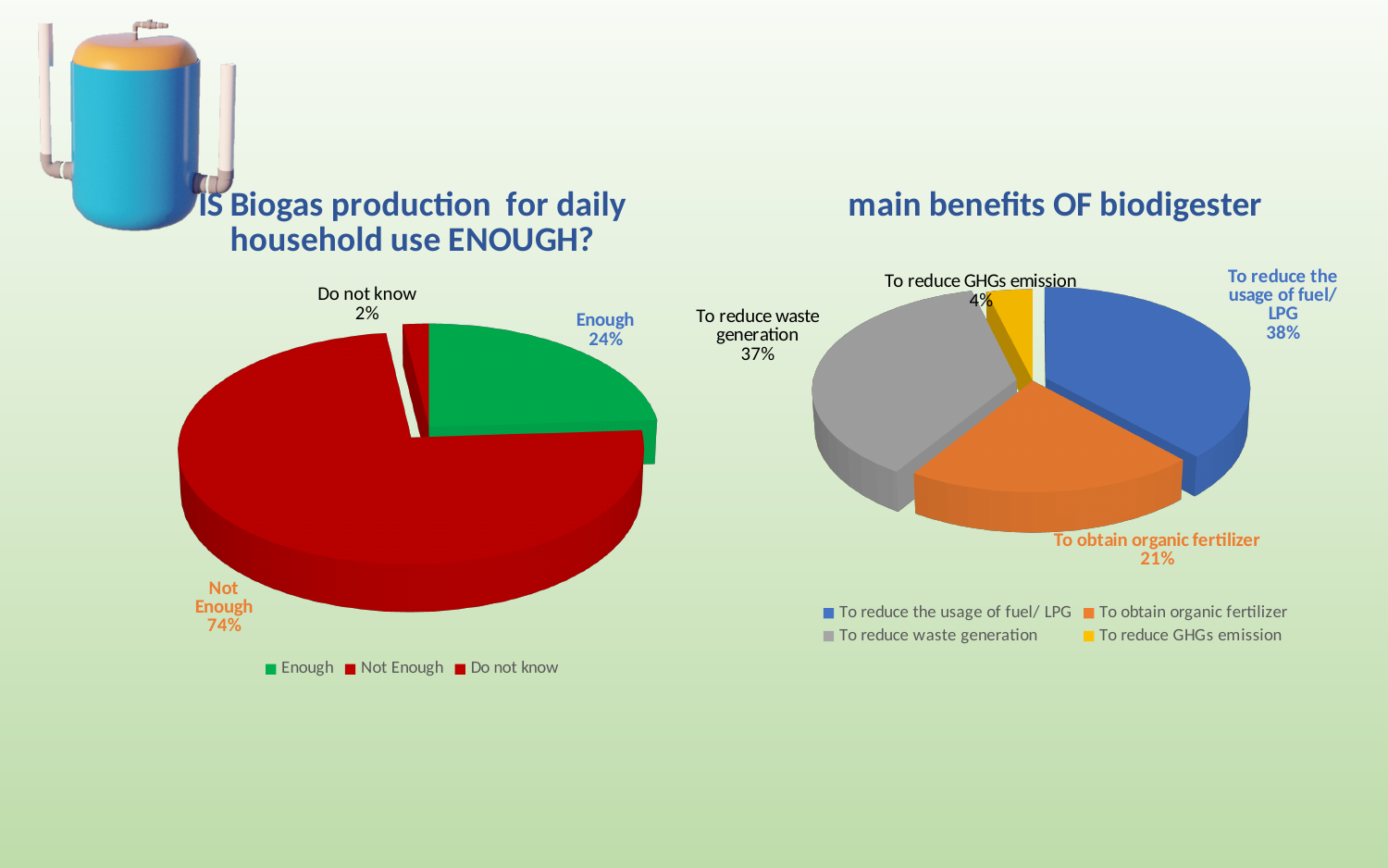
In the 'main benefits OF biodigester' chart, which is larger: 'To obtain organic fertilizer' or 'To reduce waste generation'? To reduce waste generation In the 'main benefits OF biodigester' chart, what colour is the 'To reduce GHGs emission' slice? Yellow In the 'main benefits OF biodigester' chart, which benefit has the largest share? To reduce the usage of fuel/ LPG In the 'IS Biogas production for daily household use ENOUGH?' chart, what percentage is labelled 'Not Enough'? 74% In the 'main benefits OF biodigester' chart, what percentage is labelled 'To reduce waste generation'? 37% What kind of chart is the 'main benefits OF biodigester' chart? Pie chart In the 'main benefits OF biodigester' chart, what is the difference between 'To reduce the usage of fuel/ LPG' and 'To obtain organic fertilizer'? 17% In the 'IS Biogas production for daily household use ENOUGH?' chart, how many categories does the legend list? 3 In the 'IS Biogas production for daily household use ENOUGH?' chart, which category has the smallest slice? Do not know In the 'main benefits OF biodigester' chart, what percentage is labelled 'To reduce GHGs emission'? 4% In the 'IS Biogas production for daily household use ENOUGH?' chart, what is the difference between the 'Not Enough' and 'Enough' percentages? 50% In the 'IS Biogas production for daily household use ENOUGH?' chart, what percentage is labelled 'Enough'? 24%